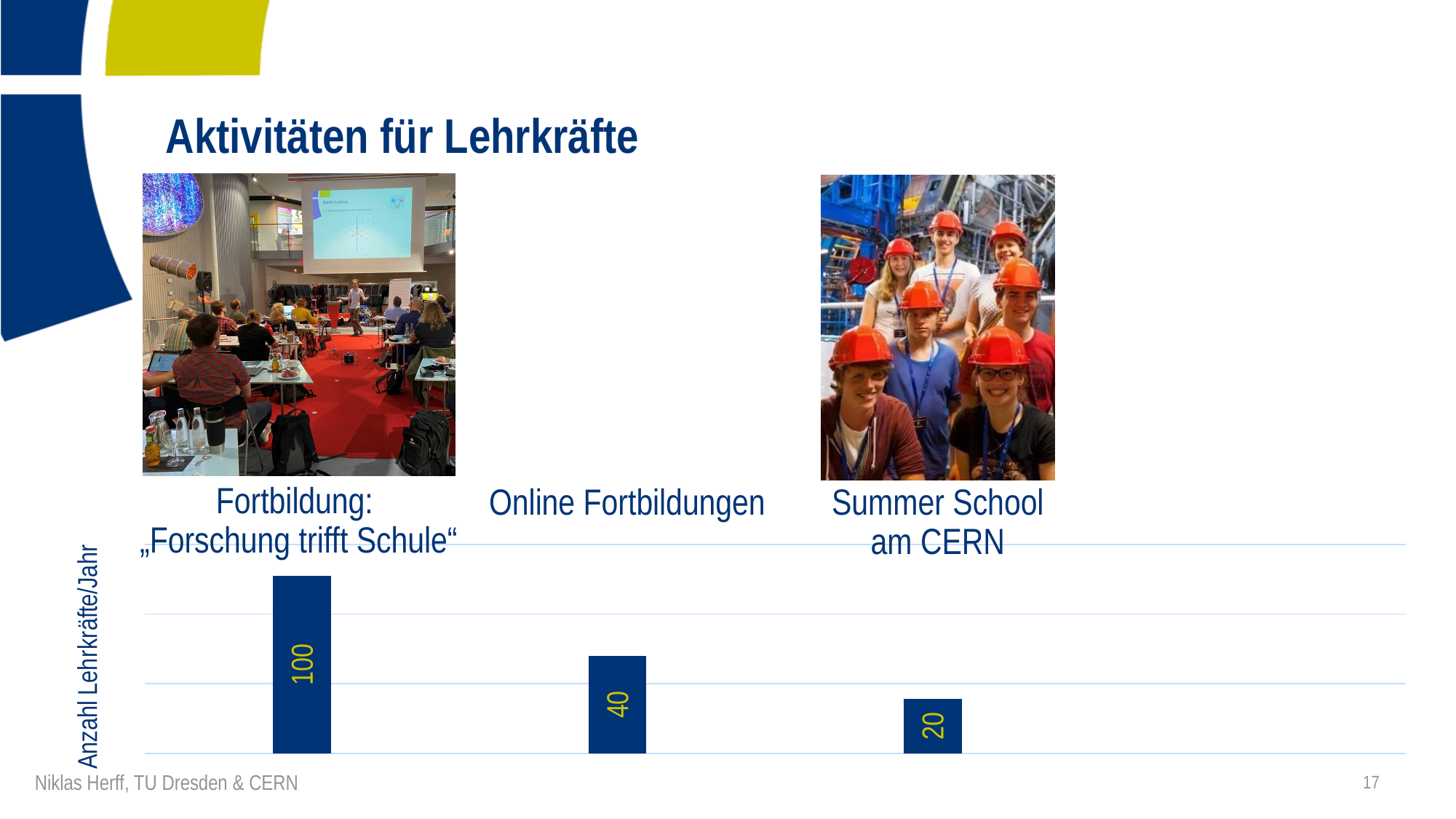
What is the value for "Summer School am CERN"? 20 Which category has the highest value? Fortbildung: „Forschung trifft Schule“ What is the difference between the values for "Online Fortbildungen" and "Summer School am CERN"? 20 How many categories are shown in the chart? 3 What is the value for "Online Fortbildungen"? 40 Which category has the lowest value? Summer School am CERN Do the values rise or fall from left to right across the categories? fall What is the value for "Fortbildung: „Forschung trifft Schule“"? 100 What is the difference between the values for "Fortbildung: „Forschung trifft Schule“" and "Online Fortbildungen"? 60 What is the label of the vertical axis of the chart? Anzahl Lehrkräfte/Jahr What kind of chart is shown on the slide? bar chart Which is larger, the value for "Online Fortbildungen" or the value for "Summer School am CERN"? Online Fortbildungen